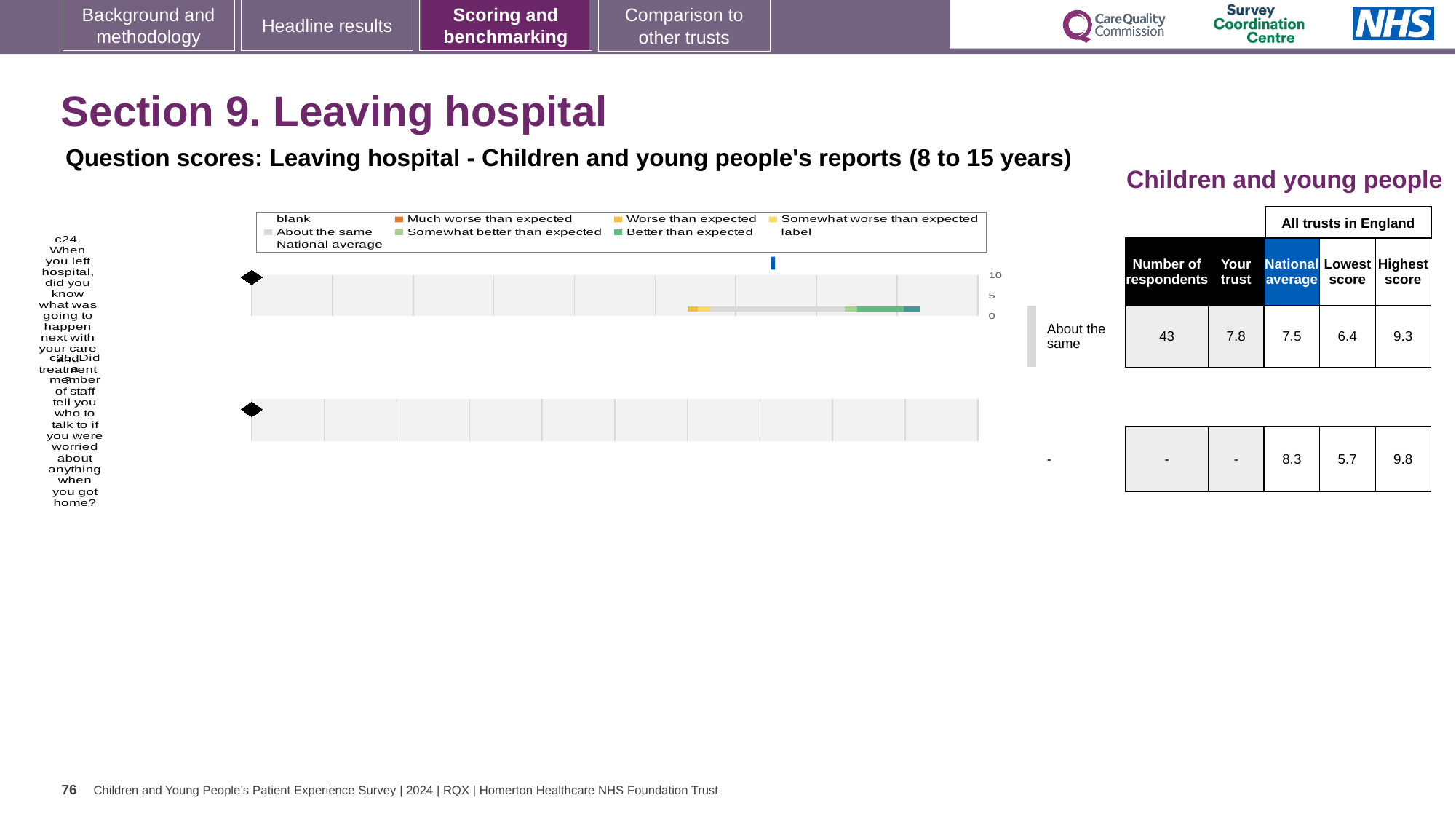
Which legend entry is shown in orange in the chart's legend? Much worse than expected What is the highest tick value shown on the chart's score axis? 10 In the table beside the chart, what is the lowest score across all trusts in England for question c24? 6.4 For question c24, which is larger: the 'Your trust' score or the national average? Your trust In the table beside the chart, what is the national average for question c24? 7.5 For question c24, what is the difference between the highest score (9.3) and the lowest score (6.4) in the table? 2.9 In the table beside the chart, what is the 'Your trust' score for question c24? 7.8 In the table beside the chart, how many respondents are listed for question c24? 43 How many questions (categories) are plotted in the chart? 2 Is the 'Your trust' score for question c24 greater or less than 5? greater In the table beside the chart, what is the national average for question c25? 8.3 What kind of chart is shown on the slide? bar chart